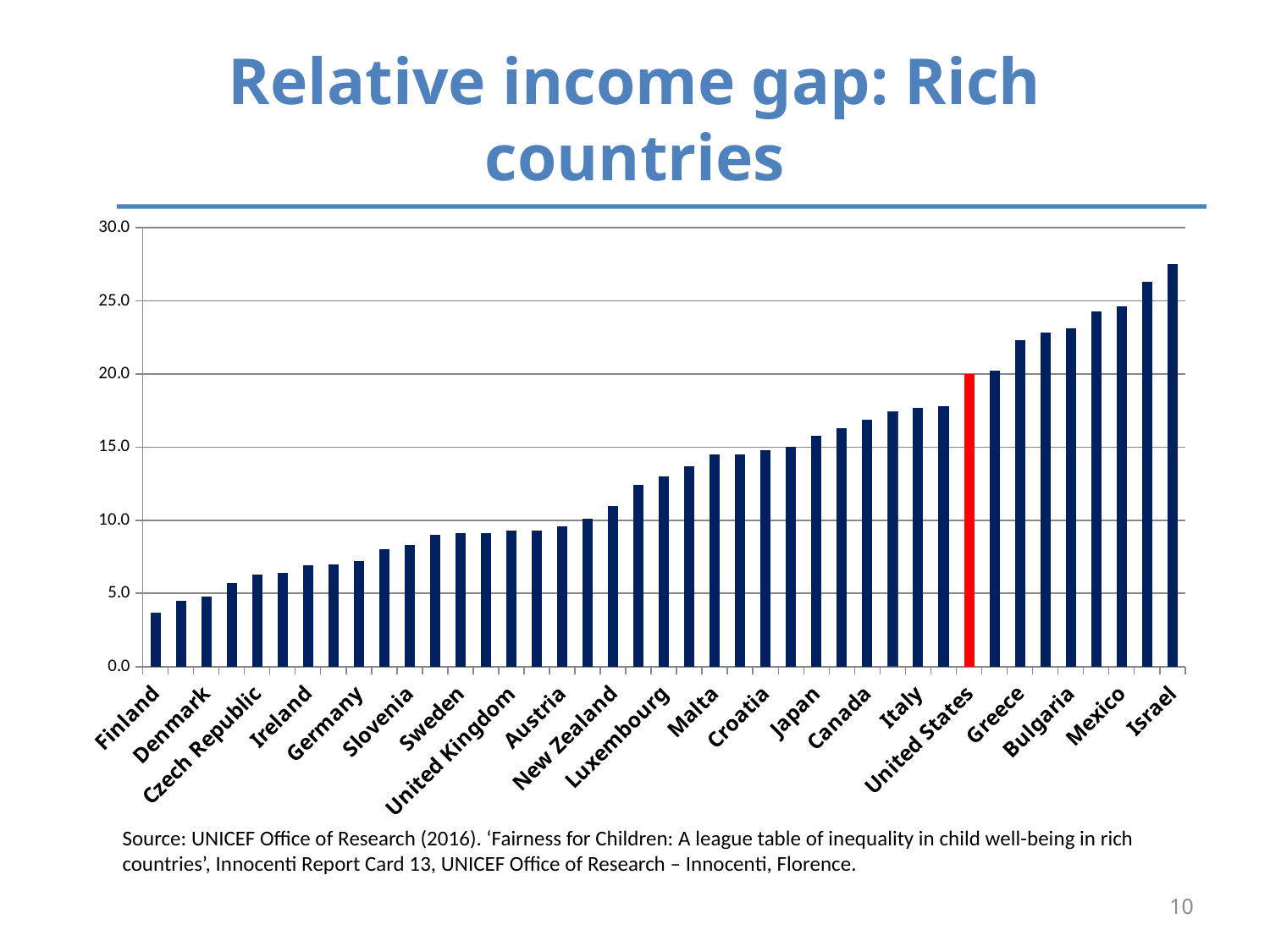
Is the value for Luxembourg greater or less than 10.0? greater Is the value for Italy greater or less than 20.0? less Is the value for Mexico greater or less than 20.0? greater Which country has the lowest relative income gap in the chart? Finland Which has a larger relative income gap, Mexico or Japan? Mexico Do the bar values rise or fall moving from left to right along the x axis? rise Which country's bar is highlighted in red? United States Which country has the highest relative income gap in the chart? Israel What kind of chart is shown on the slide? bar chart